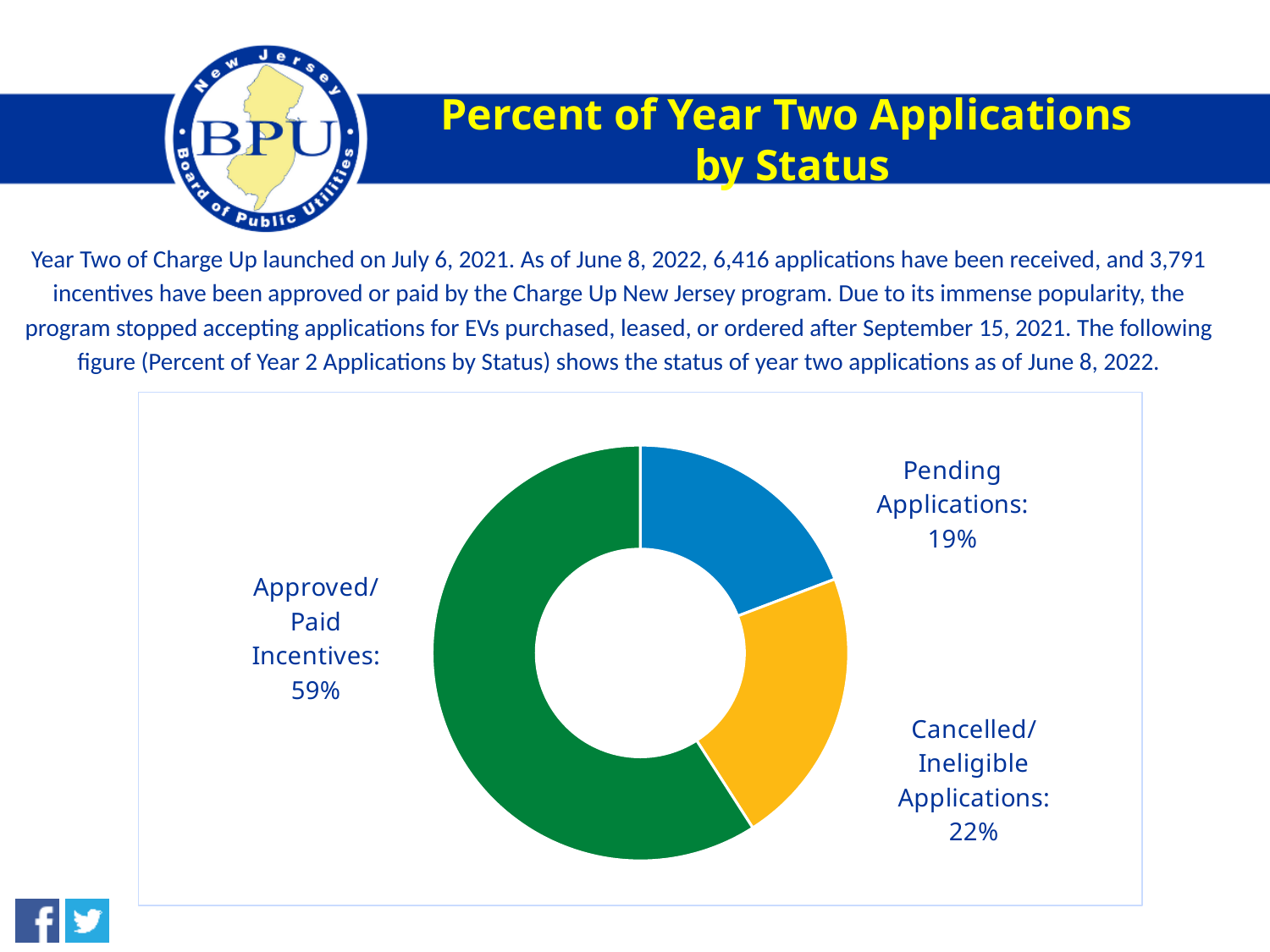
What percentage of Year Two applications are Cancelled/Ineligible Applications? 22% Which application status has the largest share of the chart? Approved/Paid Incentives What is the difference in percentage points between Approved/Paid Incentives and Cancelled/Ineligible Applications? 37 Which is larger: the share of Cancelled/Ineligible Applications or the share of Pending Applications? Cancelled/Ineligible Applications What is the difference in percentage points between Cancelled/Ineligible Applications and Pending Applications? 3 What percentage of Year Two applications are Pending Applications? 19% Which application status has the smallest share of the chart? Pending Applications How many application status categories are shown in the chart? 3 What colour is the Approved/Paid Incentives segment of the chart? Green What percentage of Year Two applications are Approved/Paid Incentives? 59% What kind of chart is shown on the slide? Doughnut (pie) chart What is the title of the slide containing the chart? Percent of Year Two Applications by Status